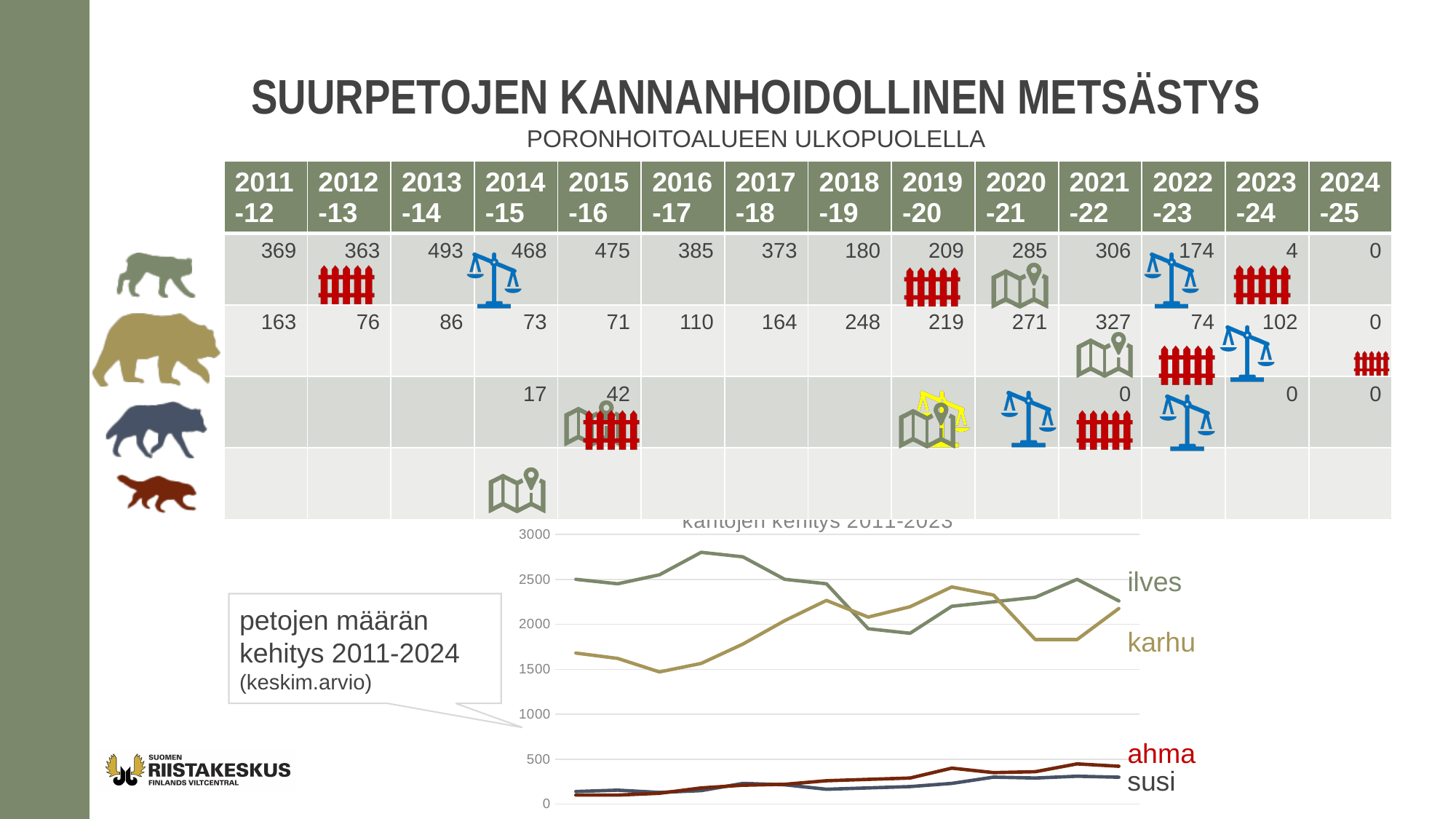
In the line chart, at the right end of the x axis, which is larger: ahma or susi? ahma In the line chart, at the left end of the x axis, which is larger: ilves or karhu? ilves In the line chart, what colour is the ahma line? red In the line chart, is the peak value of the ilves line greater or less than 2500? greater How many series are plotted in the line chart at the bottom of the slide? 4 In the line chart, is the susi line ever above 1000? no What kind of chart is shown at the bottom of the slide? line chart What is the highest value shown on the y axis of the line chart? 3000 In the line chart, which series reaches the highest value? ilves In the line chart, does the ahma line generally rise or fall from left to right? rise In the line chart, is the first value of the karhu line greater or less than 1500? greater